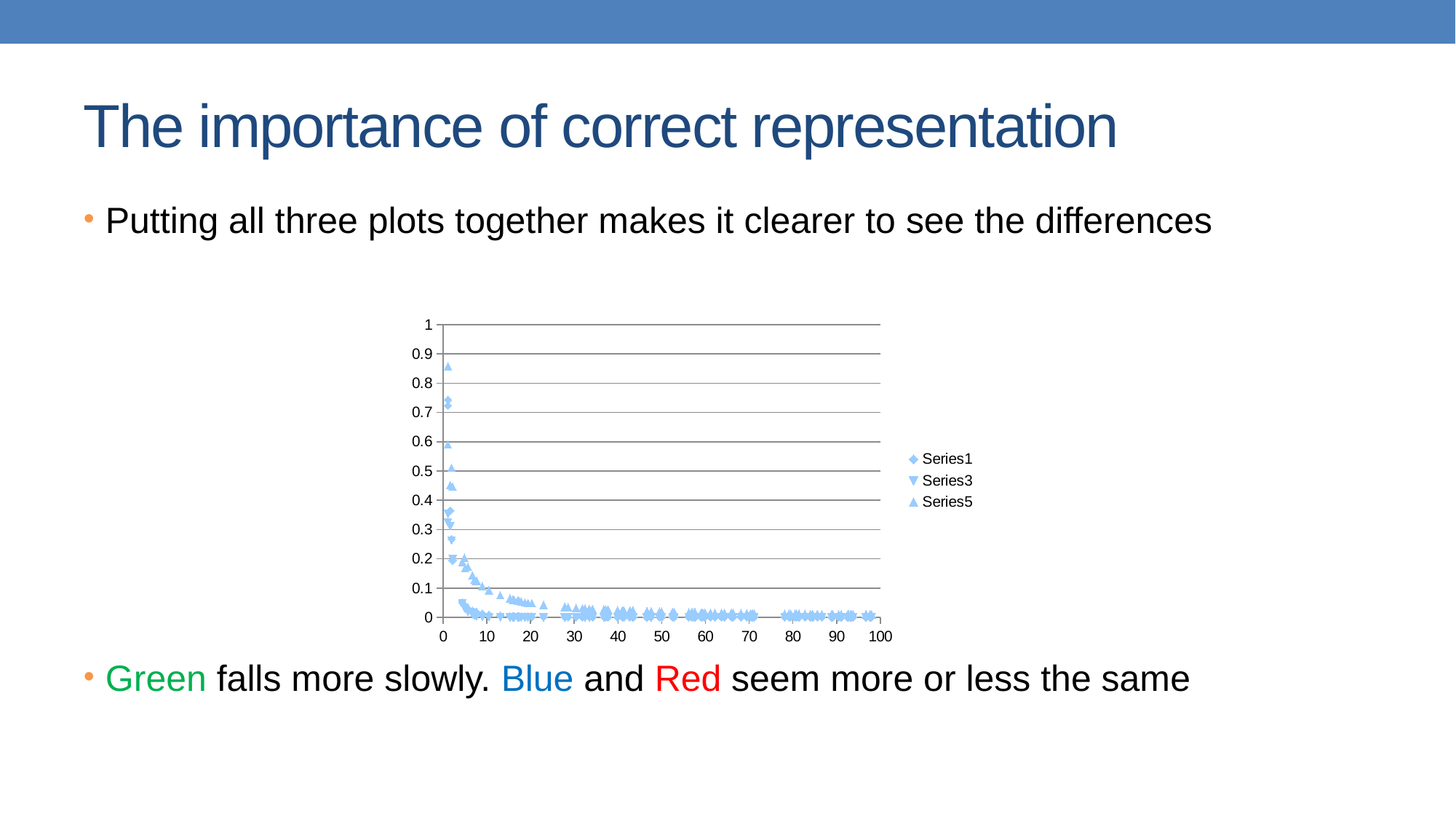
Is the highest plotted point on the chart greater or less than 0.8? greater Are the plotted values at x = 50 greater or less than 0.1? less Is the first Series1 point (near x = 1) greater or less than 0.6? greater Which series has the highest plotted value on the chart? Series5 What kind of chart is shown on the slide? Scatter chart What is the maximum value shown on the chart's y axis? 1 Do the plotted values rise or fall as x increases along the x axis? Fall What are the names of the series listed in the chart's legend? Series1, Series3, Series5 How many series does the chart's legend list? 3